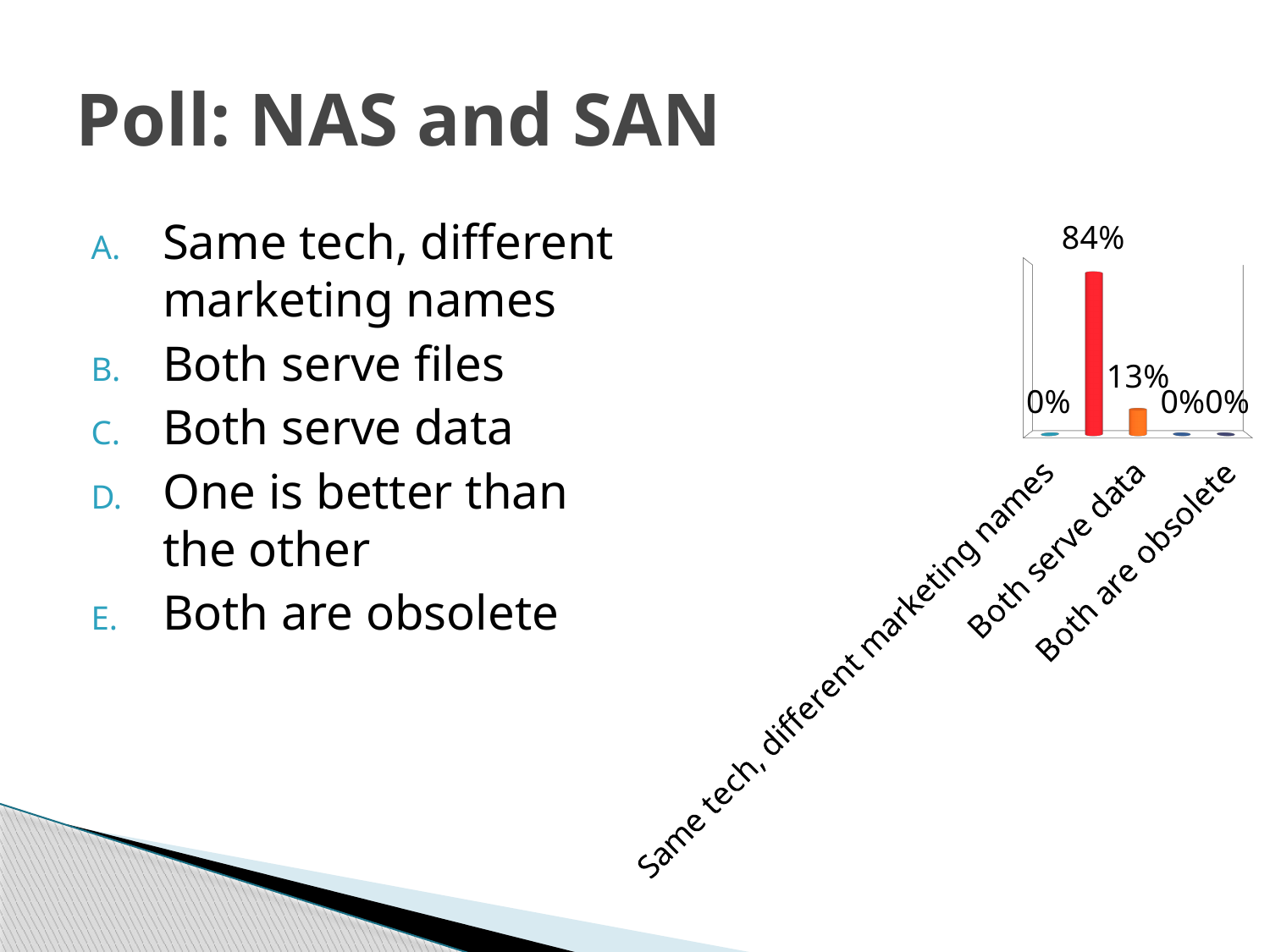
What is the highest value labelled on the chart? 84% What is the value shown for "Both are obsolete"? 0% How many bars are labelled 0%? 3 What colour is the tallest bar on the chart? Red What is the value shown for "Same tech, different marketing names"? 0% What colour is the bar for "Both serve data"? Orange What do the five data labels on the chart add up to? 97% What kind of chart is shown on the slide? Bar chart How many bars are plotted on the chart? 5 Which is larger, the value for "Both serve data" or the value for "Both are obsolete"? Both serve data What is the value shown for "Both serve data"? 13% What is the difference between the highest value (84%) and the value for "Both serve data"? 71 percentage points